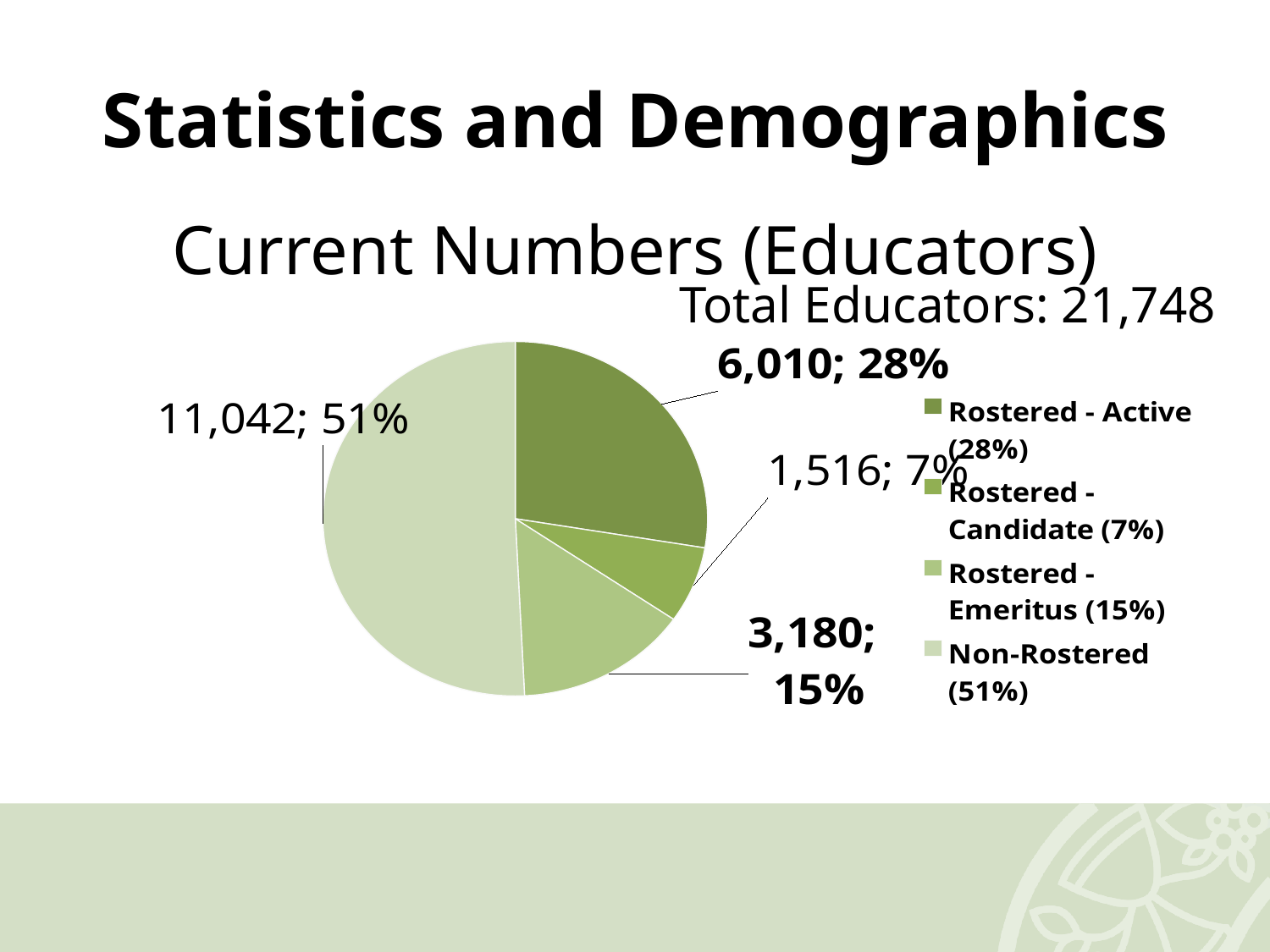
What is the value for Rostered - Emeritus? 3,180 What is the value for Rostered - Active? 6,010 What kind of chart is shown on the slide? Pie chart What share of the pie does Rostered - Emeritus represent? 15% How many entries does the legend list? 4 What is the title of the chart? Current Numbers (Educators) What is the difference between the Non-Rostered value and the Rostered - Active value? 5,032 What is the value for Non-Rostered? 11,042 How many slices does the pie chart have? 4 Which category has the largest slice of the pie? Non-Rostered Which category has the smallest slice of the pie? Rostered - Candidate What is the value for Rostered - Candidate? 1,516